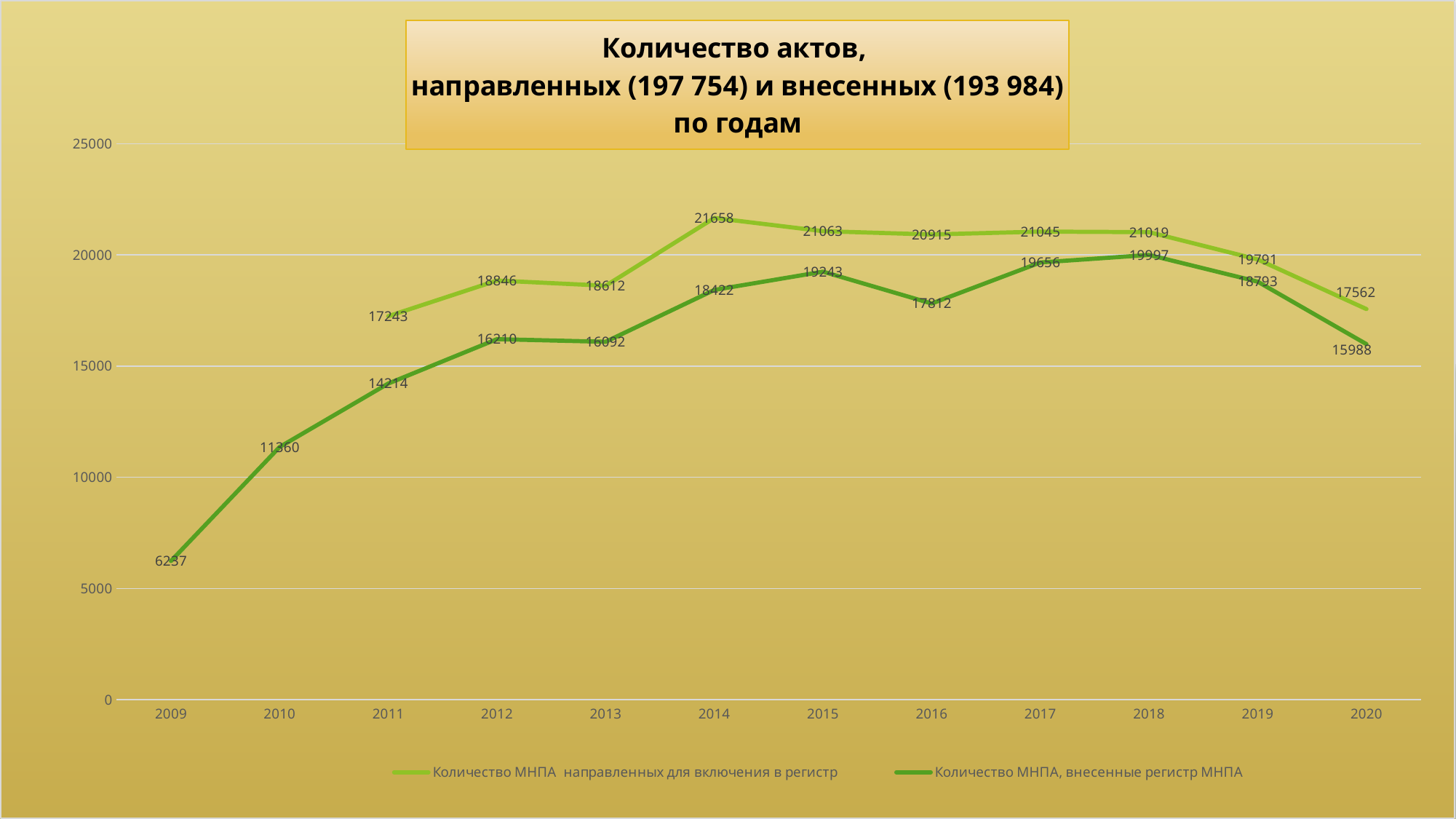
What is the difference between the two series' values in 2020? 1574 In which year does the series 'Количество МНПА, внесенные регистр МНПА' have its lowest value? 2009 In which year does the series 'Количество МНПА направленных для включения в регистр' reach its highest value? 2014 What kind of chart is shown on the slide? Line chart How many years are shown on the x axis? 12 How many series does the legend list? 2 What is the difference between the two series' values in 2014? 3236 Which series has the higher value in 2016? Количество МНПА направленных для включения в регистр What is the value of the series 'Количество МНПА направленных для включения в регистр' in 2014? 21658 What is the value of the series 'Количество МНПА, внесенные регистр МНПА' in 2009? 6237 What is the value of the series 'Количество МНПА, внесенные регистр МНПА' in 2018? 19997 Does the series 'Количество МНПА, внесенные регистр МНПА' rise or fall from 2009 to 2012? Rise